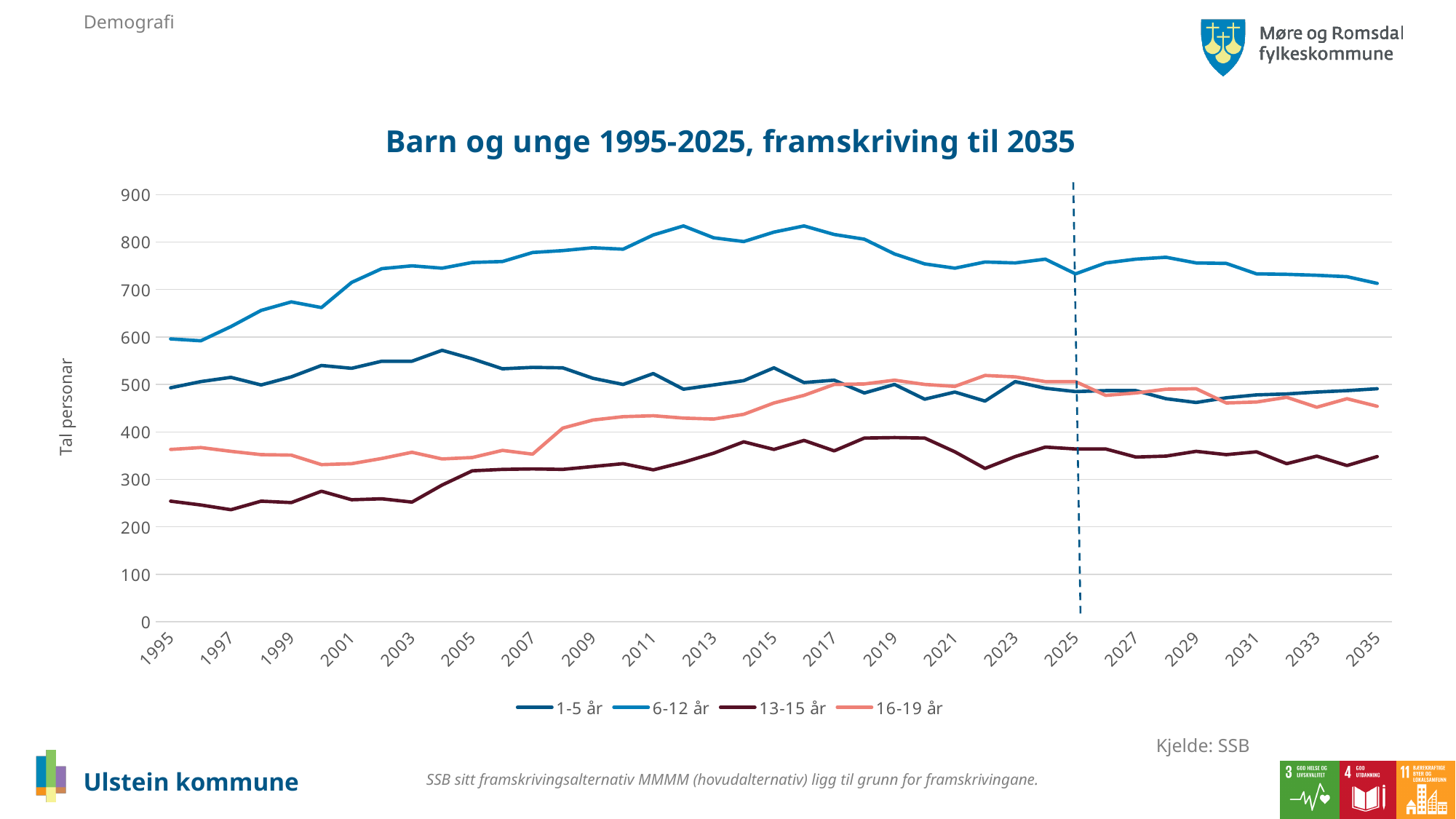
Which series has the lowest value in 2035? 13-15 år Is the value for 16-19 år in 1995 greater or less than 400? less In 2010, which is larger: the value for 6-12 år or the value for 1-5 år? 6-12 år What is the title of the chart? Barn og unge 1995-2025, framskriving til 2035 How many series does the legend list? 4 What kind of chart is shown on the slide? line chart Which series has the highest value in 2015? 6-12 år Is the value for 1-5 år in 2004 greater or less than 500? greater Does the value for 6-12 år rise or fall from 1995 to 2012? rise What is the label on the vertical axis? Tal personar Is the value for 6-12 år in 2012 greater or less than 800? greater